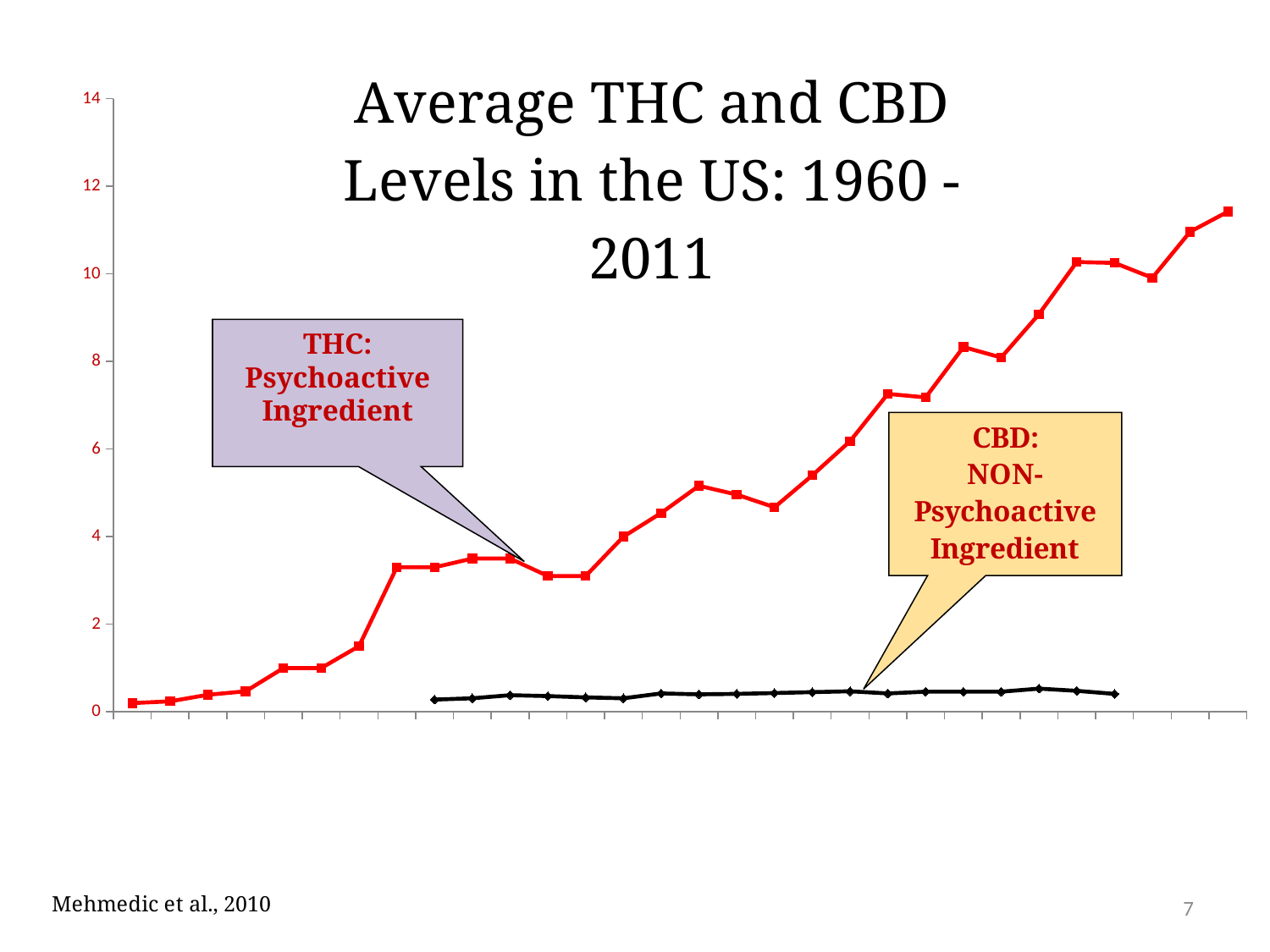
How many data series are plotted on the chart? 2 Which series stays nearly flat across the chart? CBD What is the maximum value shown on the vertical axis? 14 Is the rightmost THC value greater or less than 10? greater Does the THC line generally rise or fall from left to right? Rise Which series is drawn in red? THC Which series reaches the higher values, THC or CBD? THC Is the highest CBD value greater or less than 2? less What is the title of the chart? Average THC and CBD Levels in the US: 1960 - 2011 Is the leftmost THC value greater or less than 2? less What kind of chart is shown on the slide? Line chart